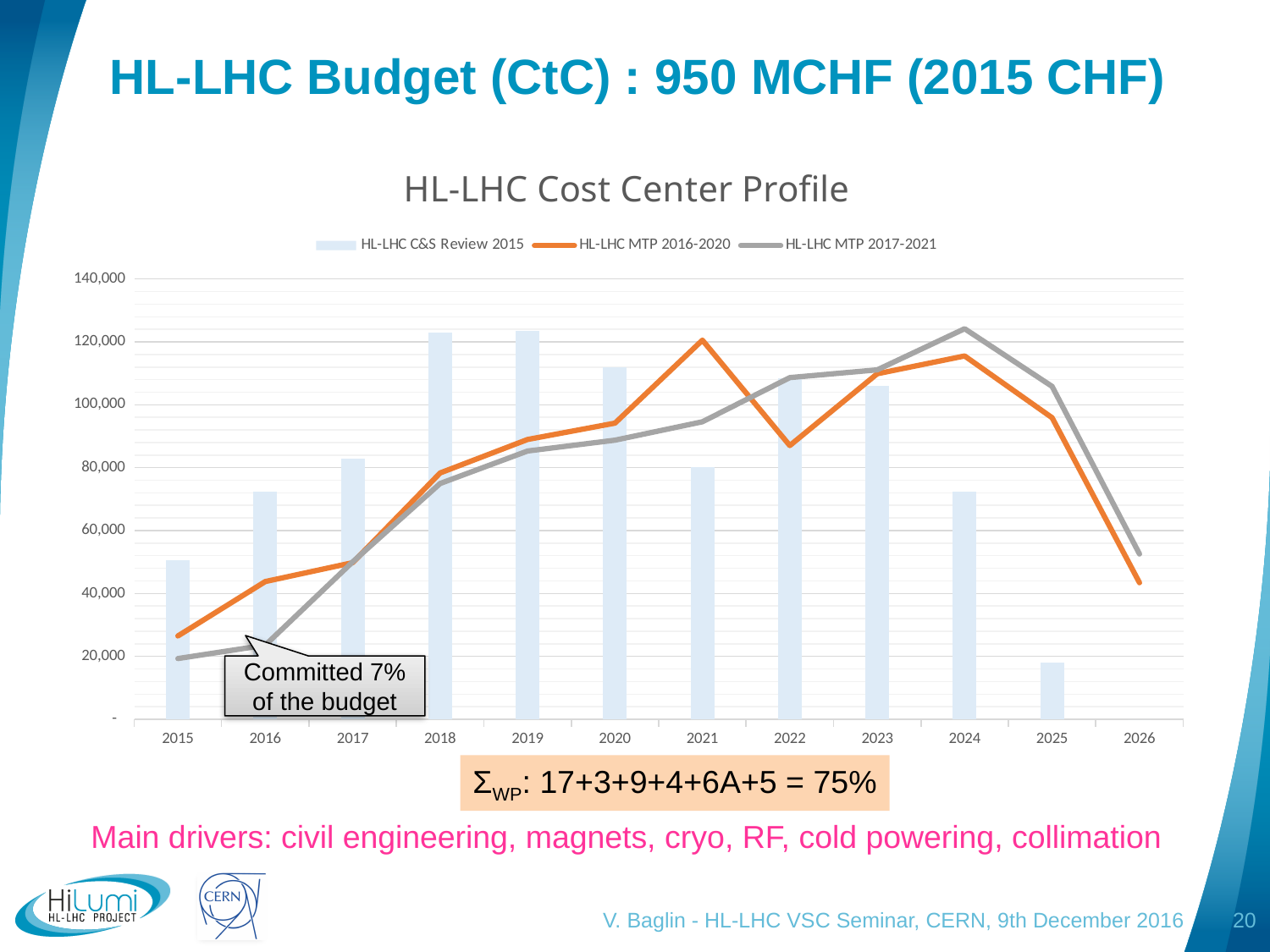
In which year does the HL-LHC MTP 2016-2020 line reach its highest value? 2021 What kind of chart is this? Combined bar and line chart In 2022, which series has the larger value: HL-LHC MTP 2016-2020 or HL-LHC MTP 2017-2021? HL-LHC MTP 2017-2021 What is the title of the chart? HL-LHC Cost Center Profile How many series does the chart legend list? 3 How many years are shown on the x axis of the chart? 12 Does the HL-LHC MTP 2017-2021 line rise or fall from 2015 to 2024? rise In which year does the HL-LHC MTP 2017-2021 line reach its highest value? 2024 Is the HL-LHC C&S Review 2015 bar for 2018 greater or less than 120,000? greater Which series is drawn as bars in the chart? HL-LHC C&S Review 2015 Is the HL-LHC MTP 2016-2020 value for 2021 greater or less than 100,000? greater